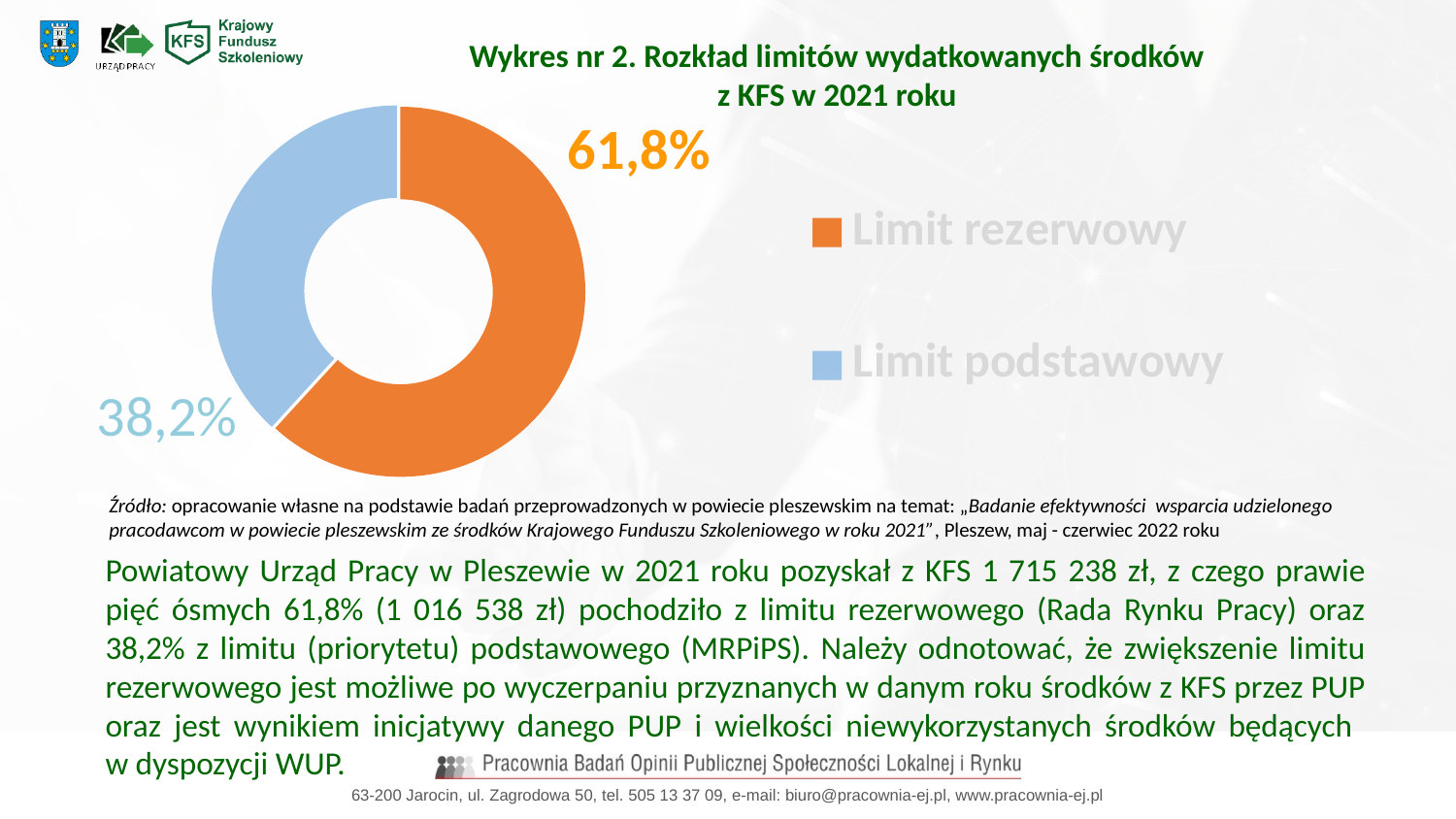
Which category has the largest share in the chart? Limit rezerwowy What type of chart is shown on the slide? Pie chart (donut) What is the difference in percentage points between "Limit rezerwowy" and "Limit podstawowy"? 23,6 What share of the chart does "Limit podstawowy" represent? 38,2% How many categories does the chart show? 2 What share of the chart does "Limit rezerwowy" represent? 61,8% What is the title of the chart? Wykres nr 2. Rozkład limitów wydatkowanych środków z KFS w 2021 roku How many entries does the legend list? 2 Which category has the smallest share in the chart? Limit podstawowy What colour is the slice for "Limit podstawowy"? Light blue Is the share of "Limit rezerwowy" greater or less than 50%? greater Which is larger: the share of "Limit rezerwowy" or "Limit podstawowy"? Limit rezerwowy